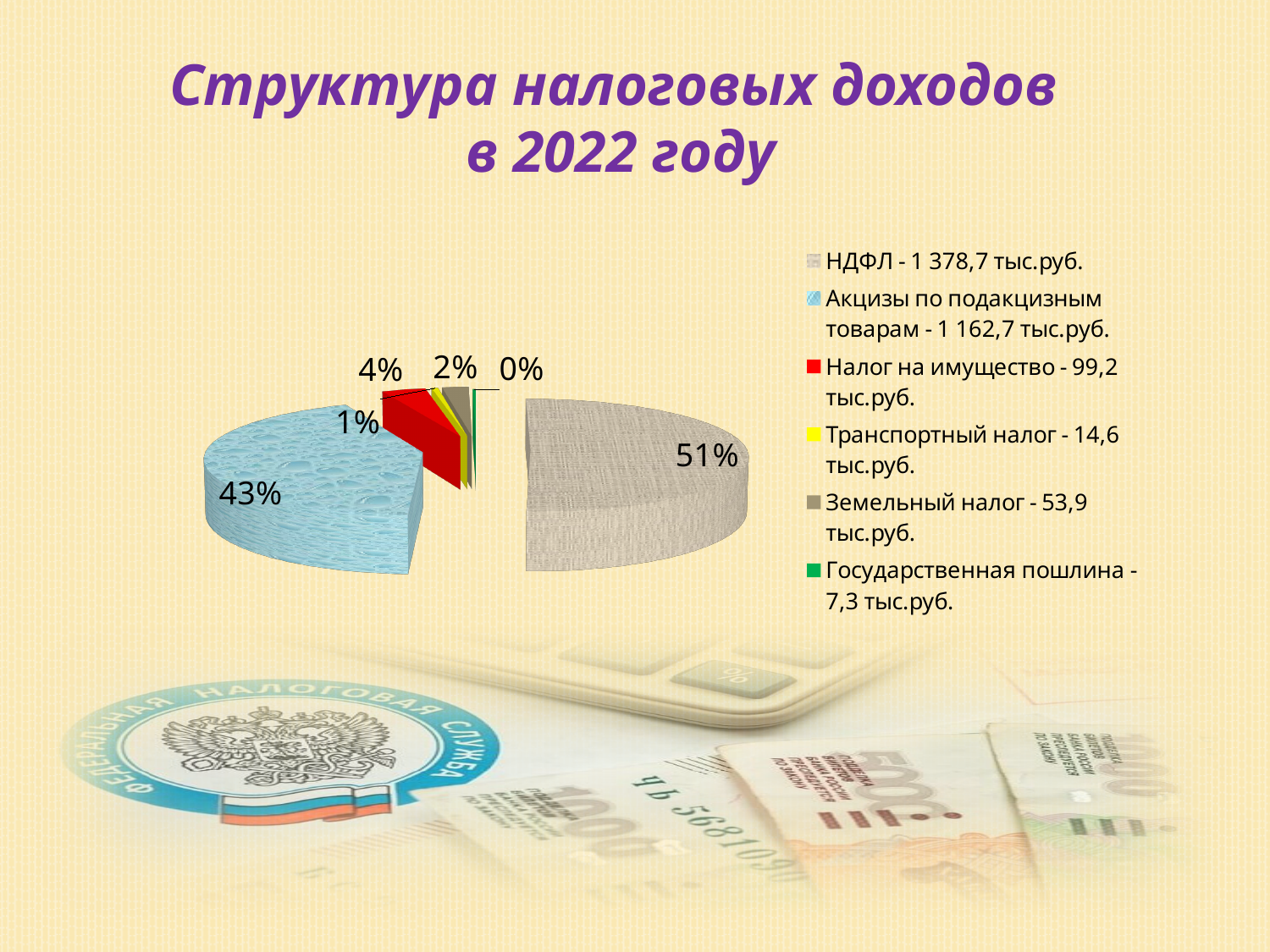
What amount in тыс.руб. does the legend give for Транспортный налог? 14,6 тыс.руб. What percentage is shown for Налог на имущество? 4% What is the title of the slide? Структура налоговых доходов в 2022 году What share of the pie does НДФЛ hold? 51% Which is larger, the slice for Налог на имущество or the slice for Земельный налог? Налог на имущество How many categories does the legend list? 6 What percentage is shown for Земельный налог? 2% What share of the pie does Акцизы по подакцизным товарам hold? 43% What is the difference in percentage points between the НДФЛ slice and the Акцизы по подакцизным товарам slice? 8 Which category has the smallest slice of the pie? Государственная пошлина Which category has the largest slice of the pie? НДФЛ What kind of chart is shown on the slide? Pie chart